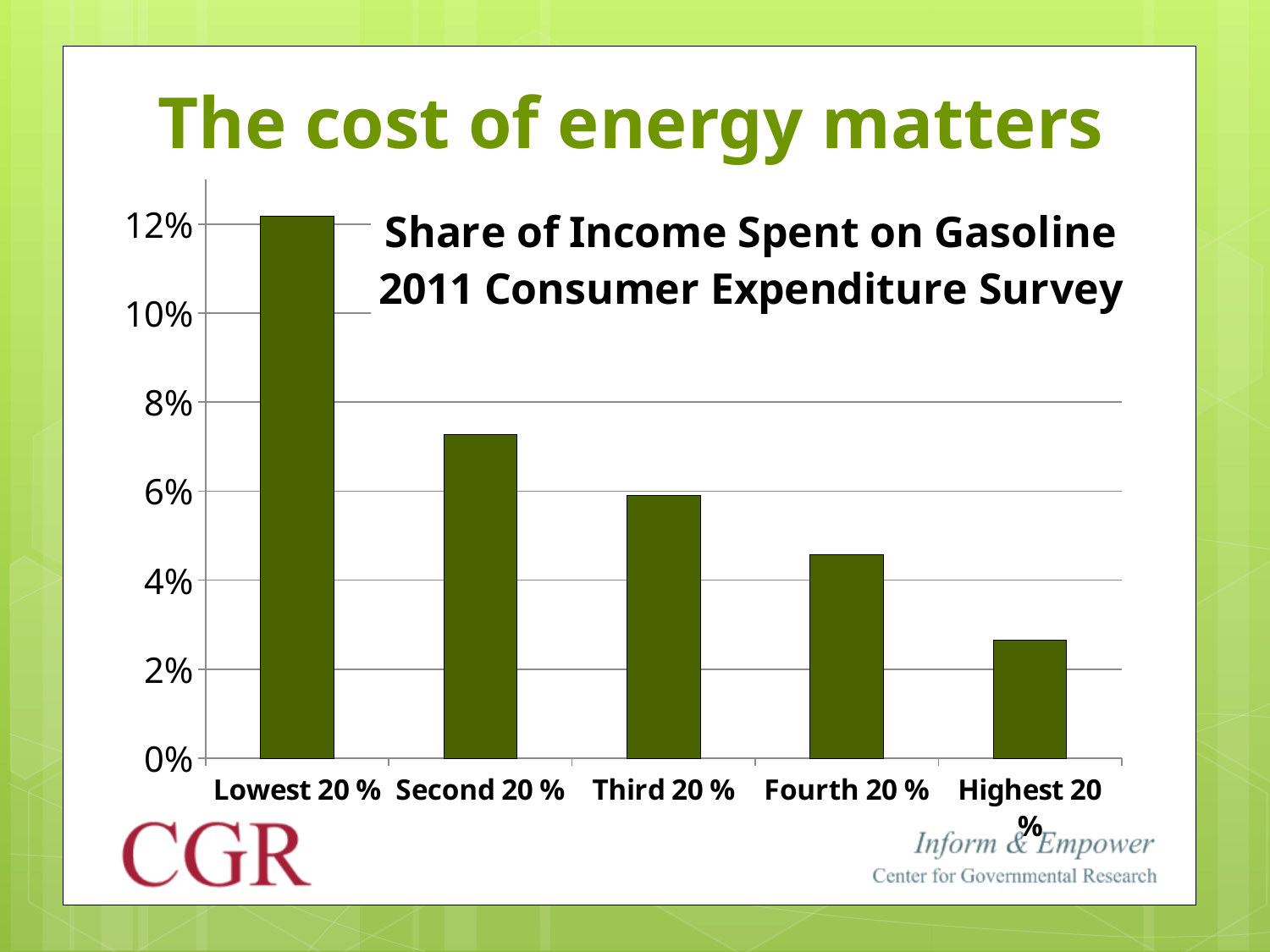
What is the title of the chart? Share of Income Spent on Gasoline 2011 Consumer Expenditure Survey Is the value for Second 20 % greater or less than 6%? greater What kind of chart is shown on the slide? bar chart Is the value for Lowest 20 % greater or less than 10%? greater Is the value for Fourth 20 % greater or less than 4%? greater Which income group has the lowest share of income spent on gasoline? Highest 20 % Which income group has the highest share of income spent on gasoline? Lowest 20 % Which is larger, the value for Second 20 % or the value for Third 20 %? Second 20 % Do the values rise or fall moving from Lowest 20 % to Highest 20 % along the x axis? fall How many income groups are shown on the x axis of the chart? 5